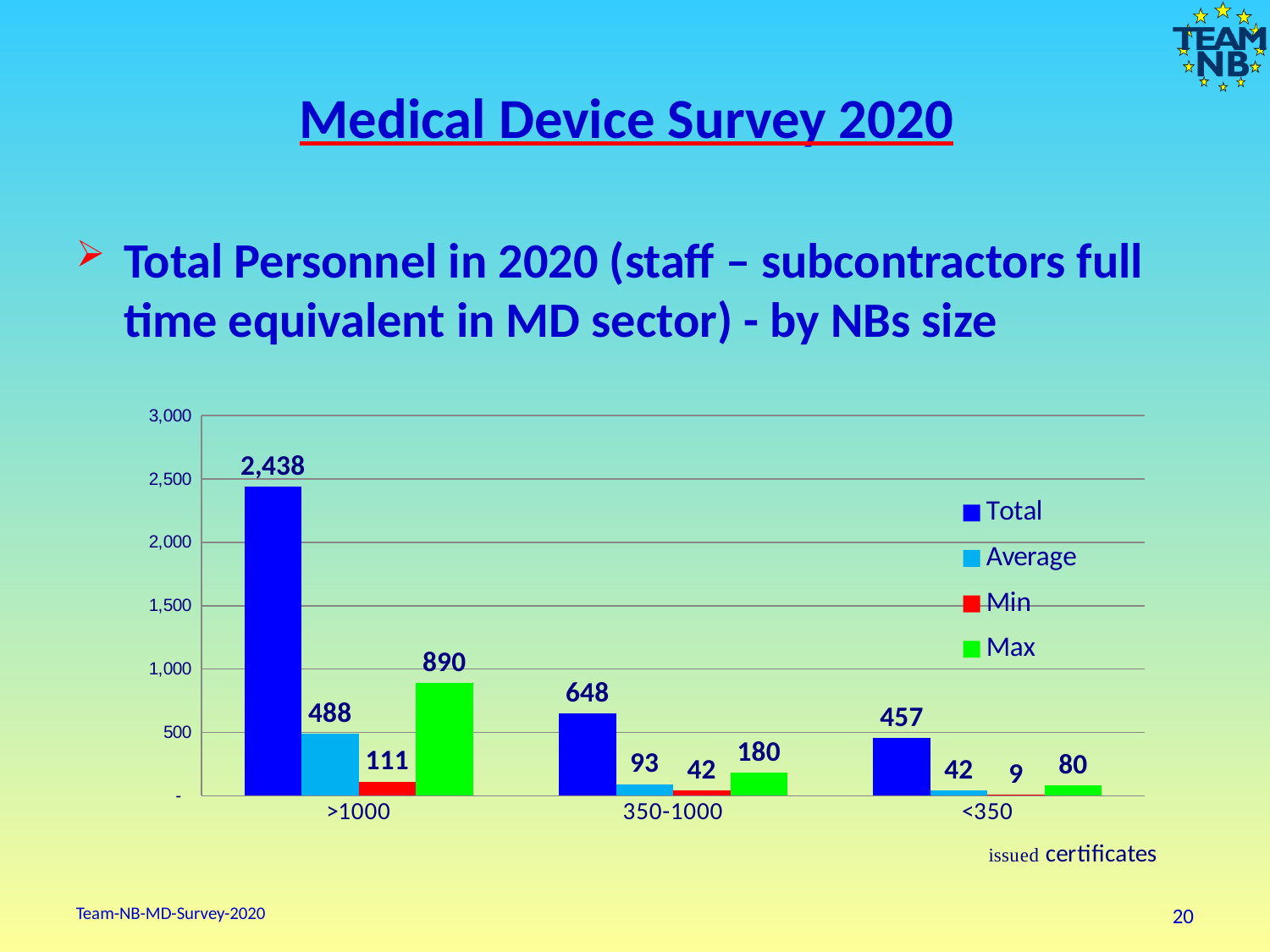
What is the Min value for the <350 category? 9 What is the Max value for the 350-1000 category? 180 How many series does the legend list? 4 What is the difference between the Total values for 350-1000 and <350? 191 How many categories are shown on the x axis? 3 Which category has the highest Total value? >1000 Is the Total value for 350-1000 greater or less than 500? greater Which is larger, the Average for >1000 or the Max for 350-1000? Average for >1000 What is the Total value for the >1000 category? 2,438 What kind of chart is shown on the slide? bar chart What is the Average value for the <350 category? 42 Which category has the lowest Max value? <350